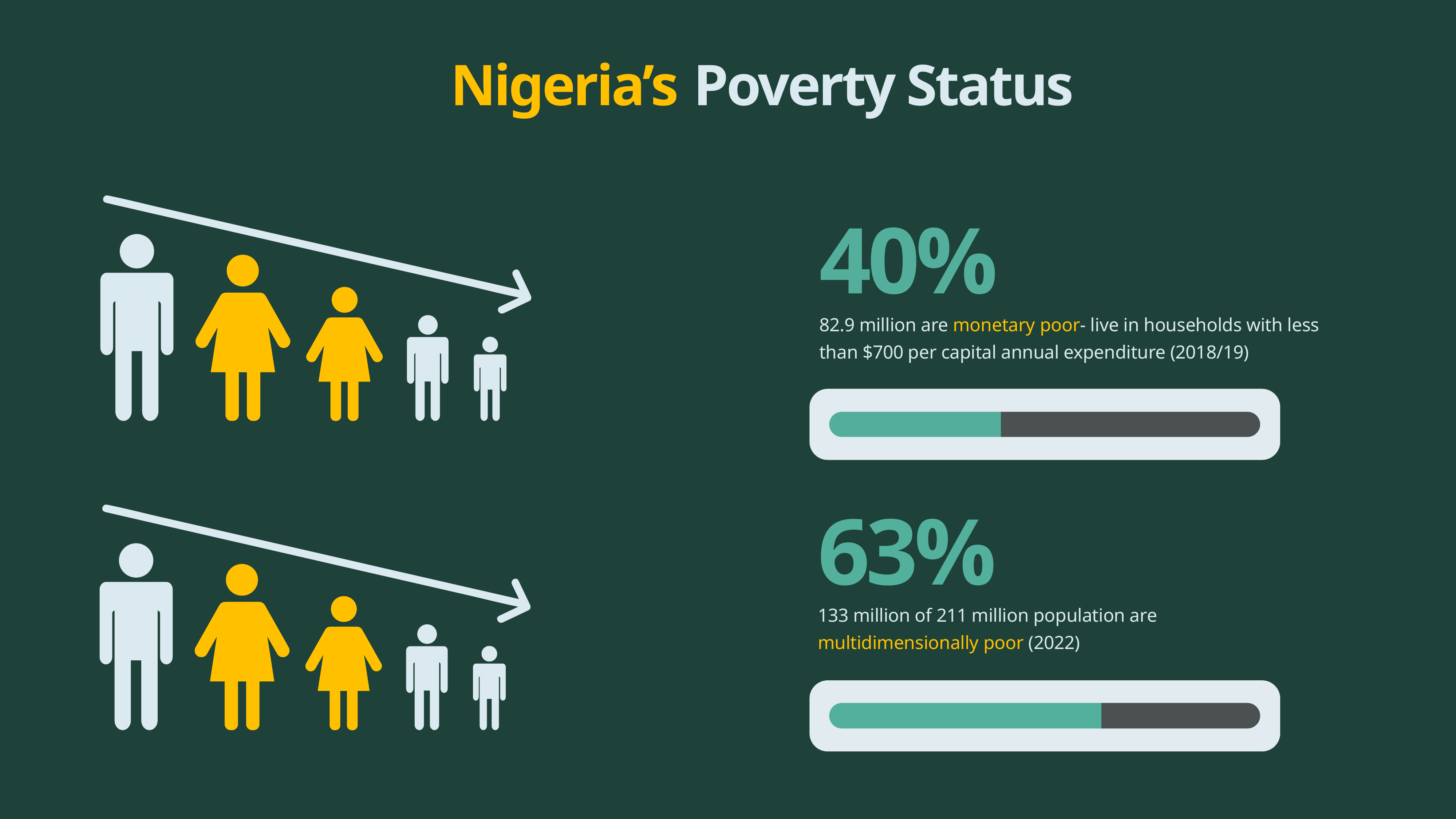
What percentage of Nigerians are shown as multidimensionally poor? 63% How many million people are described as multidimensionally poor? 133 million How many million people are described as monetary poor? 82.9 million What year is given for the multidimensionally poor statistic? 2022 Which is larger, the monetary poor percentage or the multidimensionally poor percentage? multidimensionally poor (63%) How many progress bars are shown on the slide? 2 What is the title of the slide? Nigeria's Poverty Status What total population figure is given for the multidimensionally poor statistic? 211 million What annual per capita expenditure threshold defines monetary poverty on the slide? less than $700 What percentage of Nigerians are shown as monetary poor? 40% What period is given for the monetary poor statistic? 2018/19 What is the difference in percentage points between the multidimensionally poor share (63%) and the monetary poor share (40%)? 23 percentage points